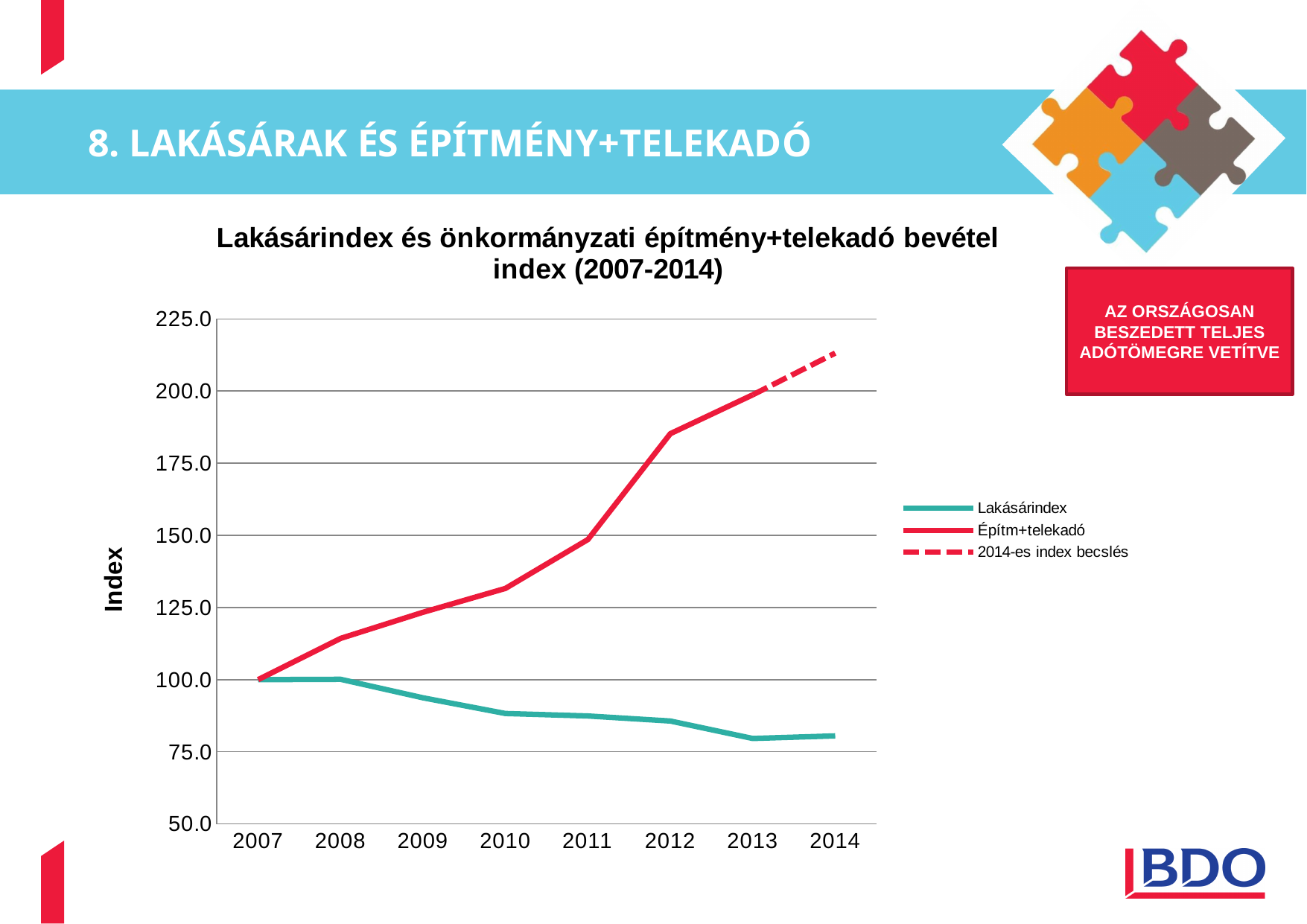
Is the value for Lakásárindex in 2013 greater or less than 100? less What is the value of Lakásárindex in 2007? 100.0 In 2012, which series has the larger value, Lakásárindex or Építm+telekadó? Építm+telekadó Does the Lakásárindex series rise or fall from 2007 to 2014? fall Is the 2014-es index becslés value in 2014 greater or less than 200? greater Does the Építm+telekadó series rise or fall from 2007 to 2013? rise What is the label of the y axis? Index How many series does the legend list? 3 What is the value of Építm+telekadó in 2007? 100.0 What kind of chart is shown on the slide? line chart Is the value for Építm+telekadó in 2012 greater or less than 175? greater How many years are shown on the x axis? 8